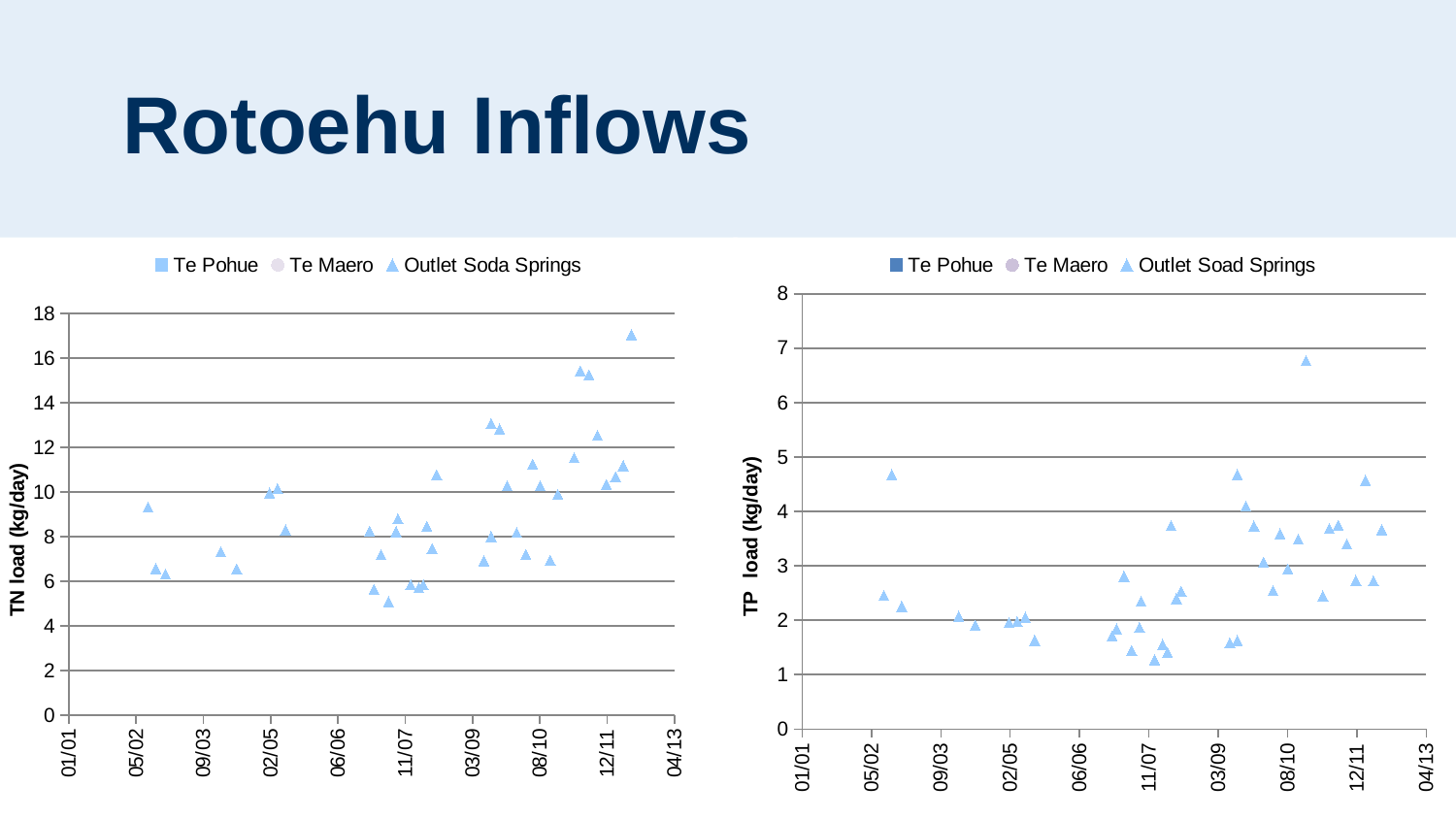
In the right chart (TP load), is the highest plotted point greater or less than 6? greater In the left chart (TN load), is the highest plotted point greater or less than 16? greater What is the y-axis label of the left chart? TN load (kg/day) In the left chart (TN load), is the lowest plotted point greater or less than 6? less How many series does the legend of the left chart (TN load) list? 3 In the left chart (TN load), do the plotted values generally rise or fall from 01/01 to 04/13? rise How many series does the legend of the right chart (TP load) list? 3 What is the y-axis label of the right chart? TP load (kg/day) What kind of chart is the left chart (TN load)? scatter chart